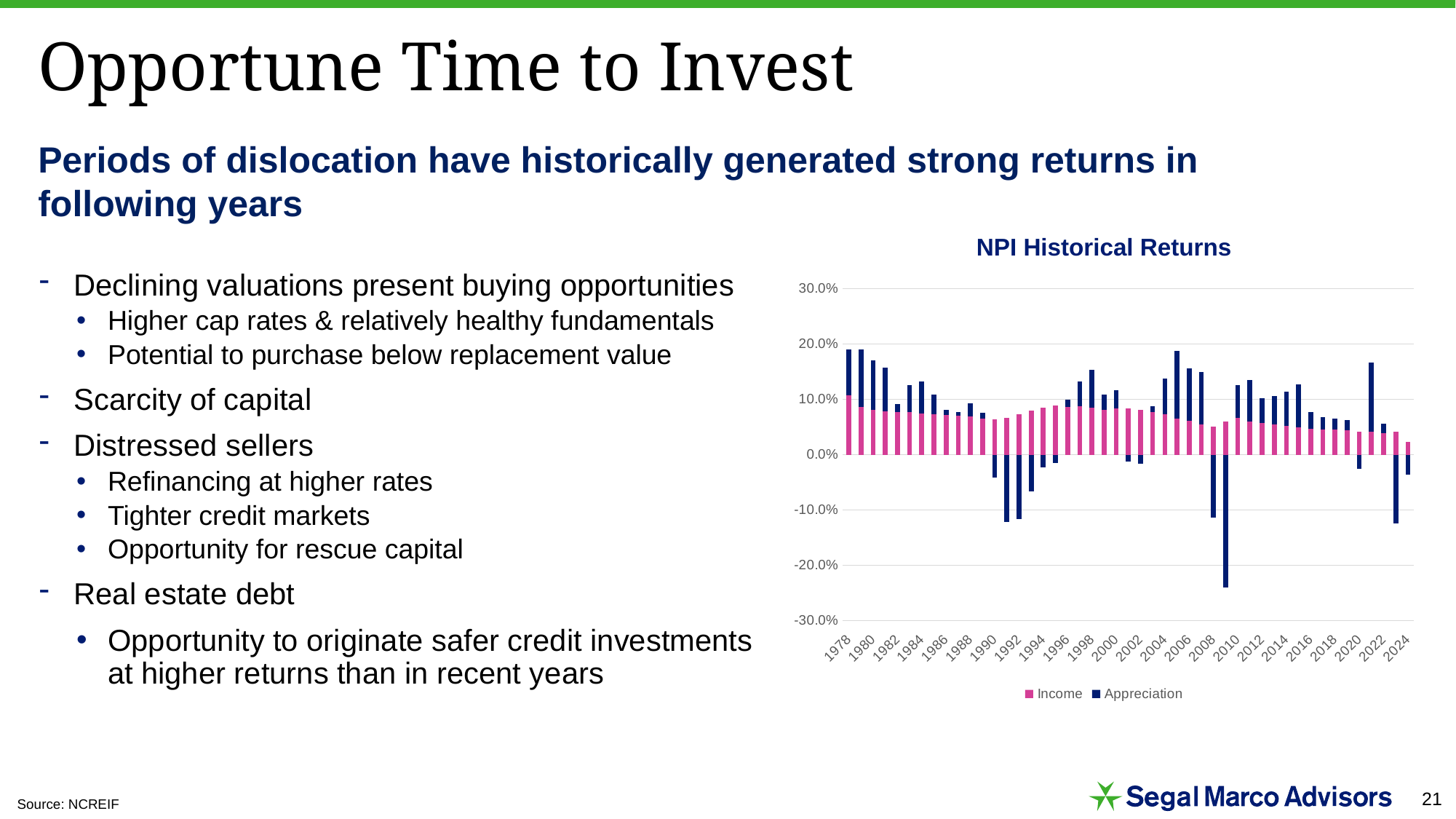
In the NPI Historical Returns chart, which year has the more negative Appreciation, 1991 or 2009? 2009 Is the Income value for 1978 in the NPI Historical Returns chart greater or less than 5.0%? greater In which year does the NPI Historical Returns chart show the lowest (most negative) Appreciation? 2009 Is the total return for 2021 in the NPI Historical Returns chart greater or less than 10.0%? greater Which colour represents Income in the NPI Historical Returns chart? pink How many series does the legend of the NPI Historical Returns chart list? 2 What is the first year and the last year labelled on the x axis of the NPI Historical Returns chart? 1978 and 2024 Is the Appreciation value for 2023 in the NPI Historical Returns chart greater or less than -5.0%? less What are the two series shown in the NPI Historical Returns chart? Income and Appreciation What kind of chart is the NPI Historical Returns chart? bar chart In the NPI Historical Returns chart, does the Income series generally rise or fall from 1978 to 2024? fall